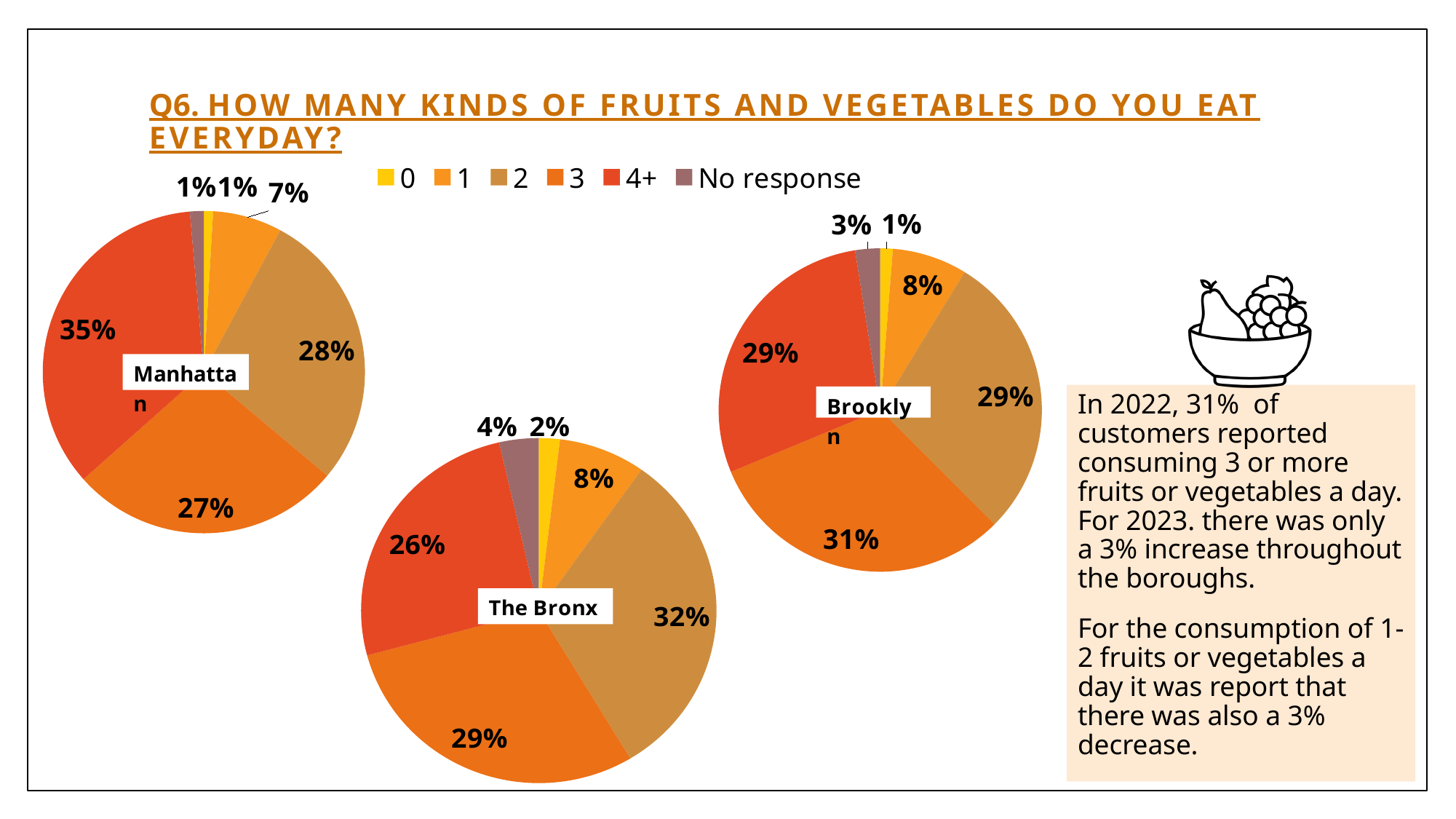
In The Bronx pie chart, which category has the smallest share? 0 In the Brooklyn pie chart, what share of respondents eat 3 kinds of fruits and vegetables every day? 31% In The Bronx pie chart, which is larger: the share for 2 or the share for 4+? 2 In The Bronx pie chart, what share of respondents gave no response? 4% In the Manhattan pie chart, which category has the largest share? 4+ In the Manhattan pie chart, what share of respondents eat 2 kinds of fruits and vegetables every day? 28% In The Bronx pie chart, what share of respondents eat 2 kinds of fruits and vegetables every day? 32% In the Manhattan pie chart, what share of respondents eat 4+ kinds of fruits and vegetables every day? 35% In the Manhattan pie chart, what is the difference between the share for 4+ and the share for 3? 8% What kind of chart is used to show the results for each borough? Pie chart How many entries does the legend list for the pie charts? 6 In the Brooklyn pie chart, what share of respondents eat 1 kind of fruit or vegetable every day? 8%